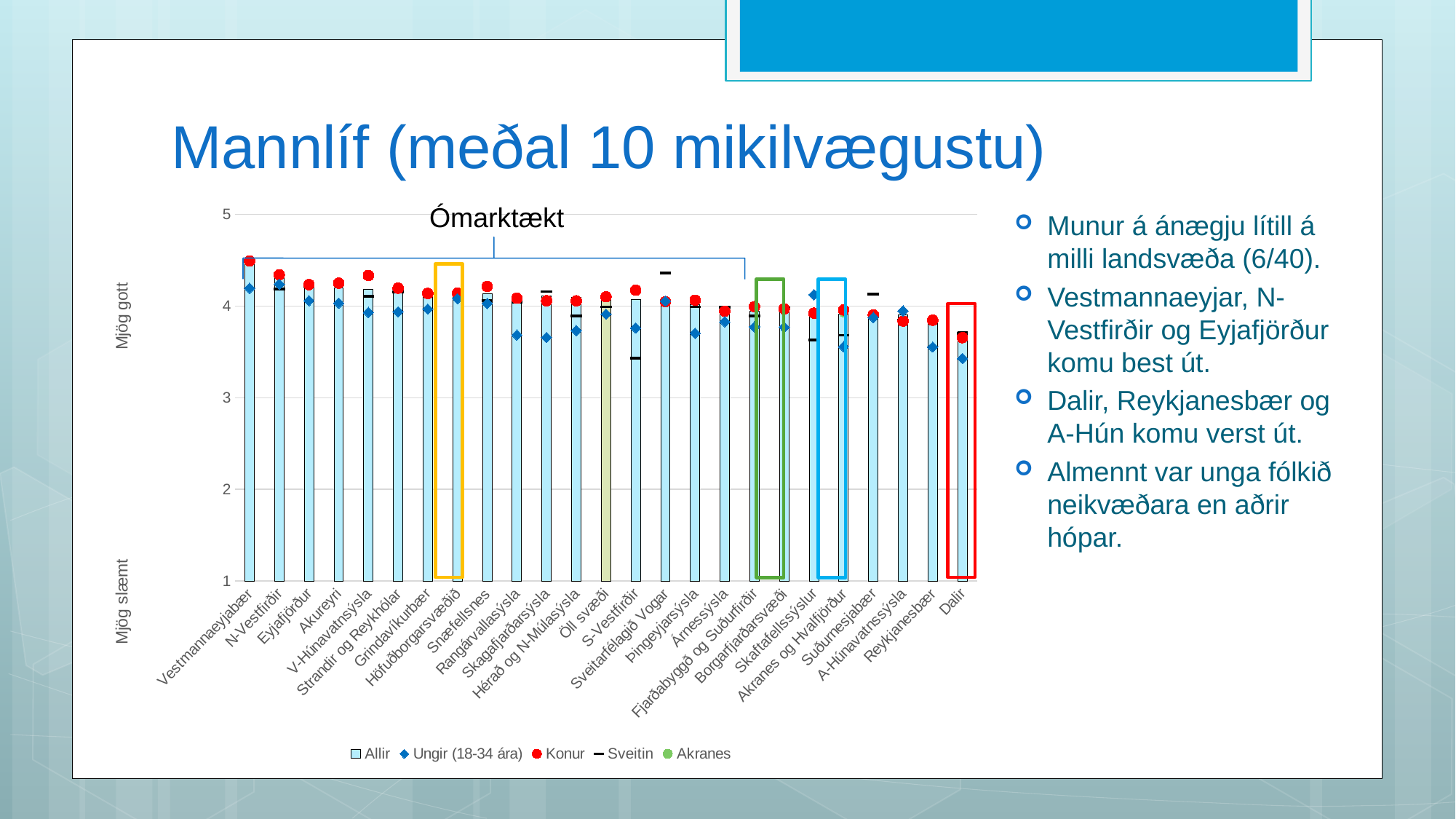
Which category has the highest Allir bar? Vestmannaeyjabær What kind of chart is shown on the slide? Bar chart Which has the larger Allir bar, Vestmannaeyjabær or Dalir? Vestmannaeyjabær How many categories are shown along the x axis? 25 How many series does the legend list? 5 Which series is shown with red circle markers? Konur Is the Allir value for Reykjanesbær greater or less than 4? less Is the Allir value for Dalir greater or less than 4? less Which category has the lowest Allir bar? Dalir Do the Allir bars generally rise or fall from left to right along the x axis? fall What is the title of the chart? Mannlíf (meðal 10 mikilvægustu) Is the Allir value for Vestmannaeyjabær greater or less than 4? greater